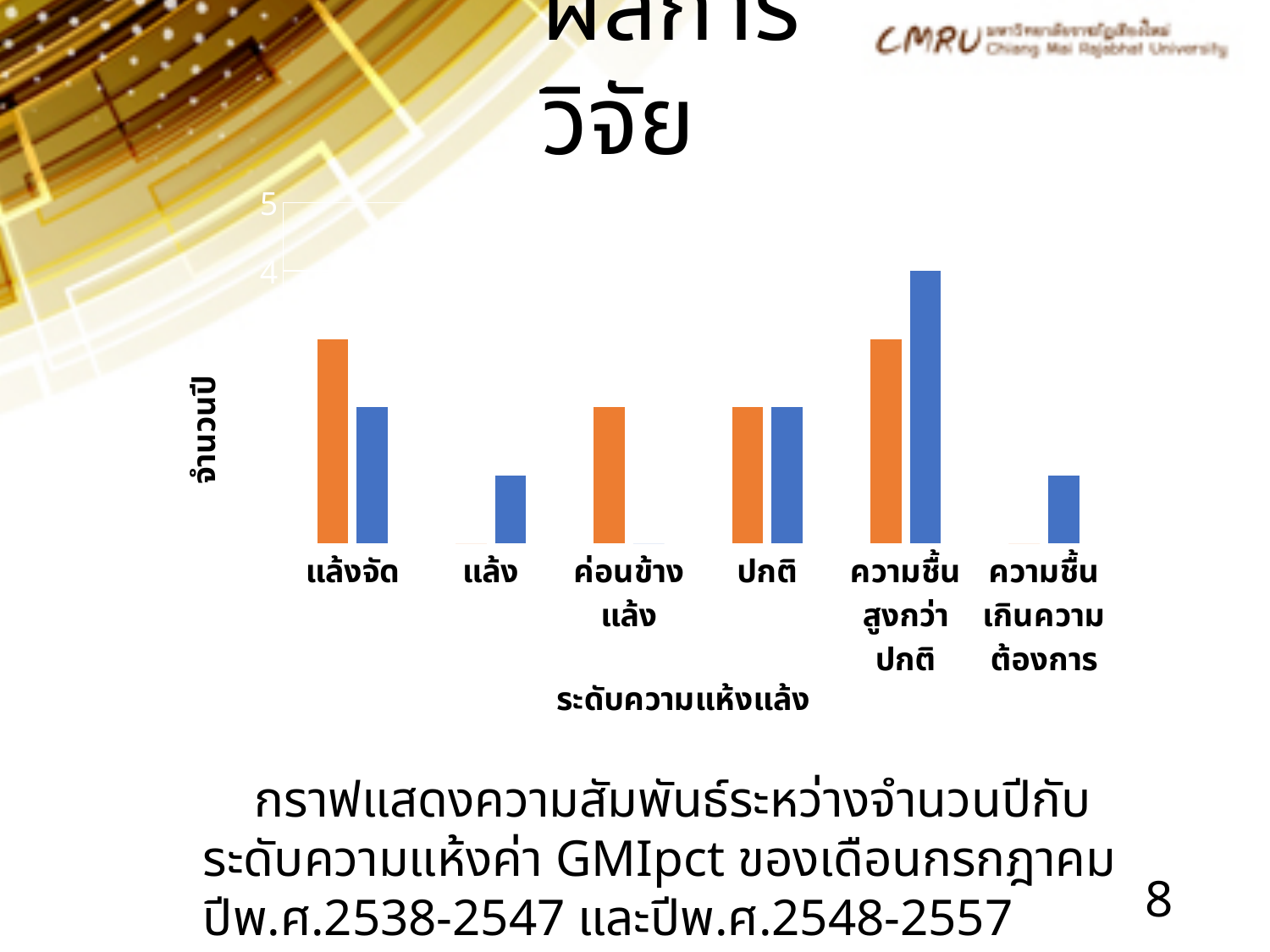
For แล้งจัด, which bar is taller, the orange one or the blue one? orange How many categories are shown on the x axis of the chart? 6 For ความชื้นสูงกว่าปกติ, which bar is taller, the orange one or the blue one? blue What kind of chart is shown on the slide? bar chart Is the value of the orange bar for ความชื้นสูงกว่าปกติ greater or less than 4? less What is the title of the horizontal axis of the chart? ระดับความแห้งแล้ง Which category has the lowest blue bar (no blue bar visible)? ค่อนข้างแล้ง Is the value of the orange bar for แล้งจัด greater or less than 4? less Is the value of the blue bar for ความชื้นสูงกว่าปกติ greater or less than 5? less What is the value of the blue bar for ความชื้นสูงกว่าปกติ? 4 What is the title of the vertical axis of the chart? จำนวนปี Which category has the tallest bar in the chart? ความชื้นสูงกว่าปกติ